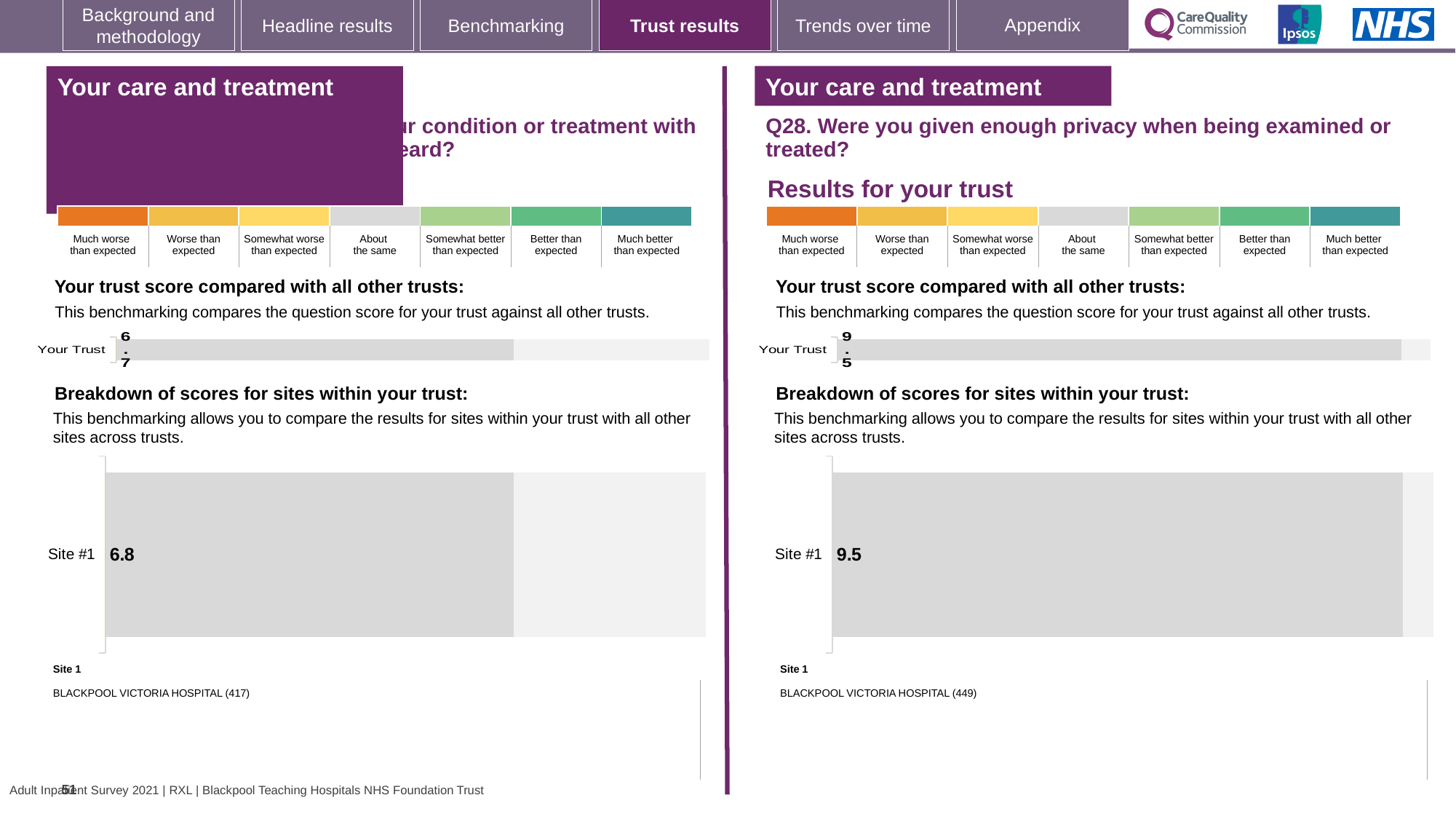
Is the Site #1 score for Q28 greater or less than the Site #1 score on the left half of the slide? greater Which is larger: the 'Your Trust' score on the left half of the slide or the 'Your Trust' score for Q28 on the right? Q28 on the right For Q28 (privacy when being examined or treated), what score is shown for Site #1 in the breakdown of scores for sites chart? 9.5 For Q28 (privacy when being examined or treated), what is the 'Your Trust' score shown in the trust benchmarking chart? 9.5 On the left half of the slide, what score is shown for Site #1 in the breakdown of scores for sites chart? 6.8 On the left half of the slide, what is the difference between the Site #1 score and the 'Your Trust' score? 0.1 How many sites are shown in the breakdown of scores chart for Q28? 1 On the left half of the slide, what is the 'Your Trust' score shown in the trust benchmarking chart? 6.7 What is the difference between the Site #1 score for Q28 on the right and the Site #1 score on the left half of the slide? 2.7 What kind of chart is used to show the Site #1 score for Q28? Bar chart Which site is listed as Site 1 under the breakdown chart on the left half of the slide? BLACKPOOL VICTORIA HOSPITAL (417) Which site is listed as Site 1 under the Q28 breakdown chart? BLACKPOOL VICTORIA HOSPITAL (449)